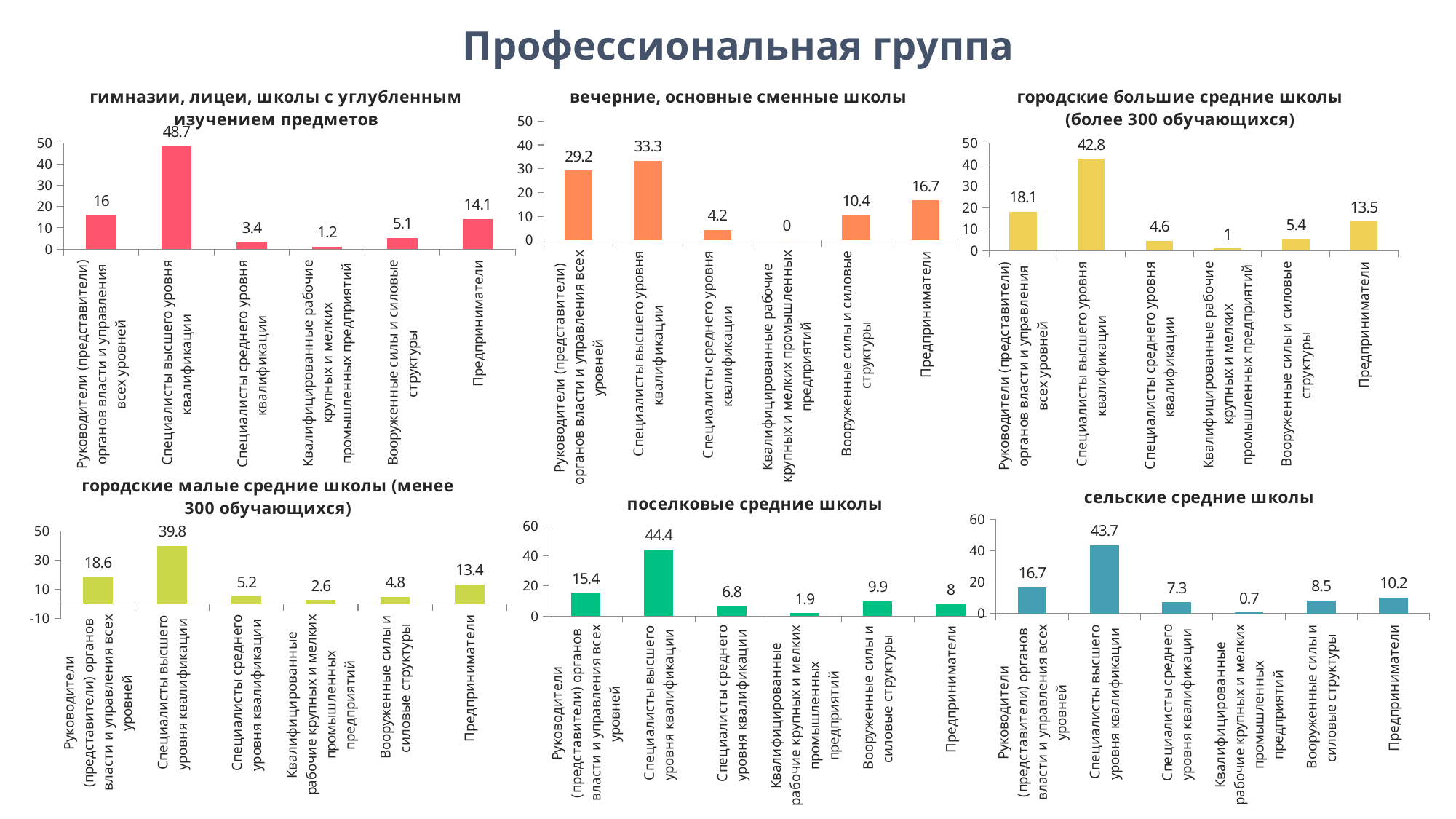
In the chart 'сельские средние школы', what is the difference between the values for 'Специалисты высшего уровня квалификации' and 'Руководители (представители) органов власти и управления всех уровней'? 27 In the chart 'городские большие средние школы (более 300 обучающихся)', is the value for 'Специалисты высшего уровня квалификации' greater or less than 40? greater In the chart 'городские большие средние школы (более 300 обучающихся)', which category has the lowest value? Квалифицированные рабочие крупных и мелких промышленных предприятий In the chart 'поселковые средние школы', what is the value for 'Предприниматели'? 8 In the chart 'гимназии, лицеи, школы с углубленным изучением предметов', what is the value for 'Специалисты высшего уровня квалификации'? 48.7 In the chart 'вечерние, основные сменные школы', what is the value for 'Квалифицированные рабочие крупных и мелких промышленных предприятий'? 0 How many categories are shown in the chart 'сельские средние школы'? 6 In the chart 'поселковые средние школы', which category has the highest value? Специалисты высшего уровня квалификации How many charts are shown on the slide? 6 In the chart 'вечерние, основные сменные школы', what is the value for 'Руководители (представители) органов власти и управления всех уровней'? 29.2 In the chart 'городские малые средние школы (менее 300 обучающихся)', which is larger: the value for 'Предприниматели' or for 'Вооруженные силы и силовые структуры'? Предприниматели What type of chart is 'поселковые средние школы'? Bar chart